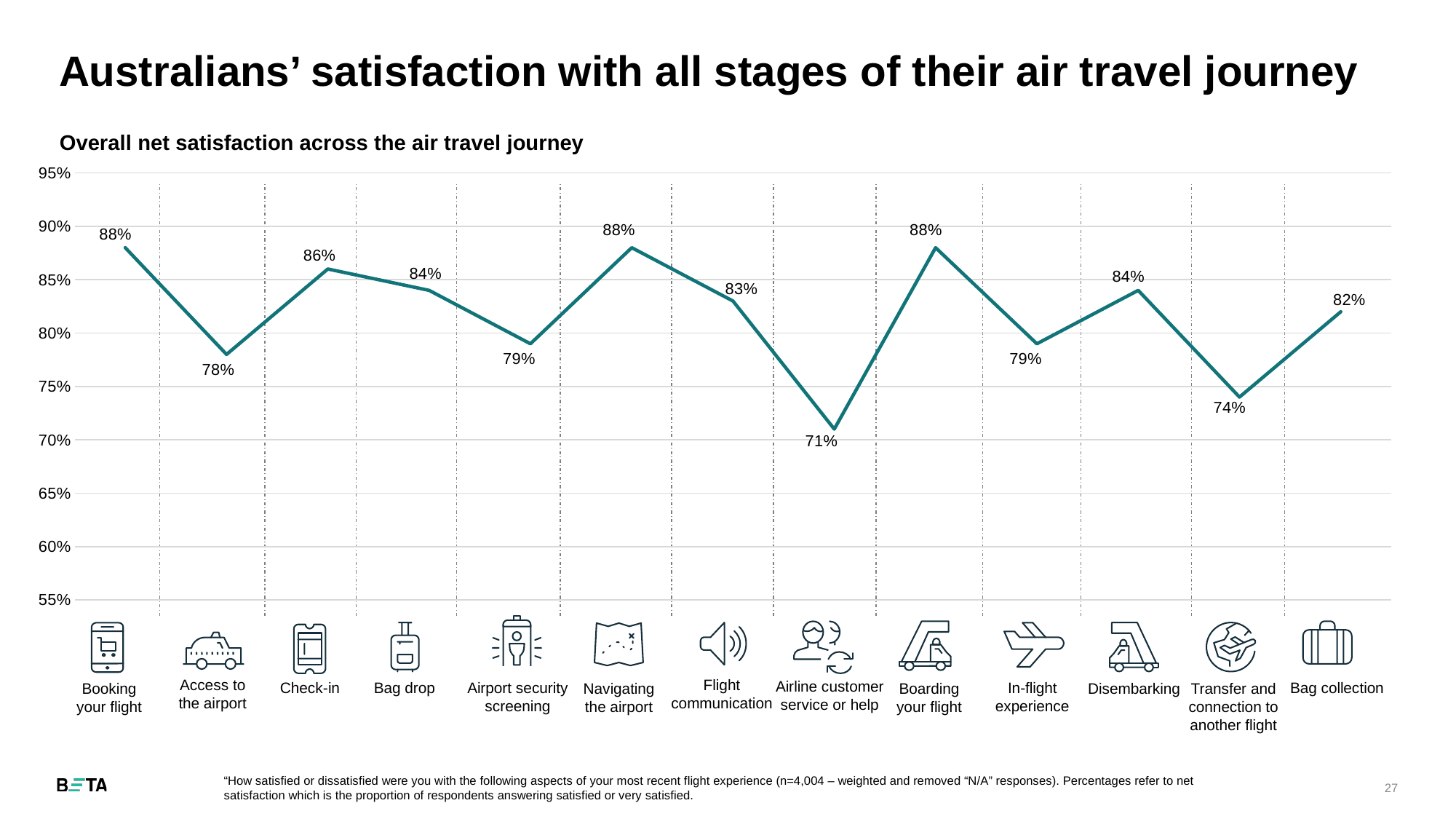
What is the net satisfaction value for Transfer and connection to another flight? 74% Which stage has the lowest net satisfaction? Airline customer service or help What is the title of the chart? Overall net satisfaction across the air travel journey What is the net satisfaction value for Bag collection? 82% Which has a higher net satisfaction, Bag drop or Airport security screening? Bag drop What is the net satisfaction value for Check-in? 86% What is the difference between the net satisfaction for Booking your flight and Access to the airport? 10% Which has a higher net satisfaction, Flight communication or In-flight experience? Flight communication What is the difference between the net satisfaction for Disembarking and Transfer and connection to another flight? 10% What type of chart is shown on the slide? Line chart How many stages of the air travel journey are plotted on the chart? 13 What is the net satisfaction value for Airline customer service or help? 71%